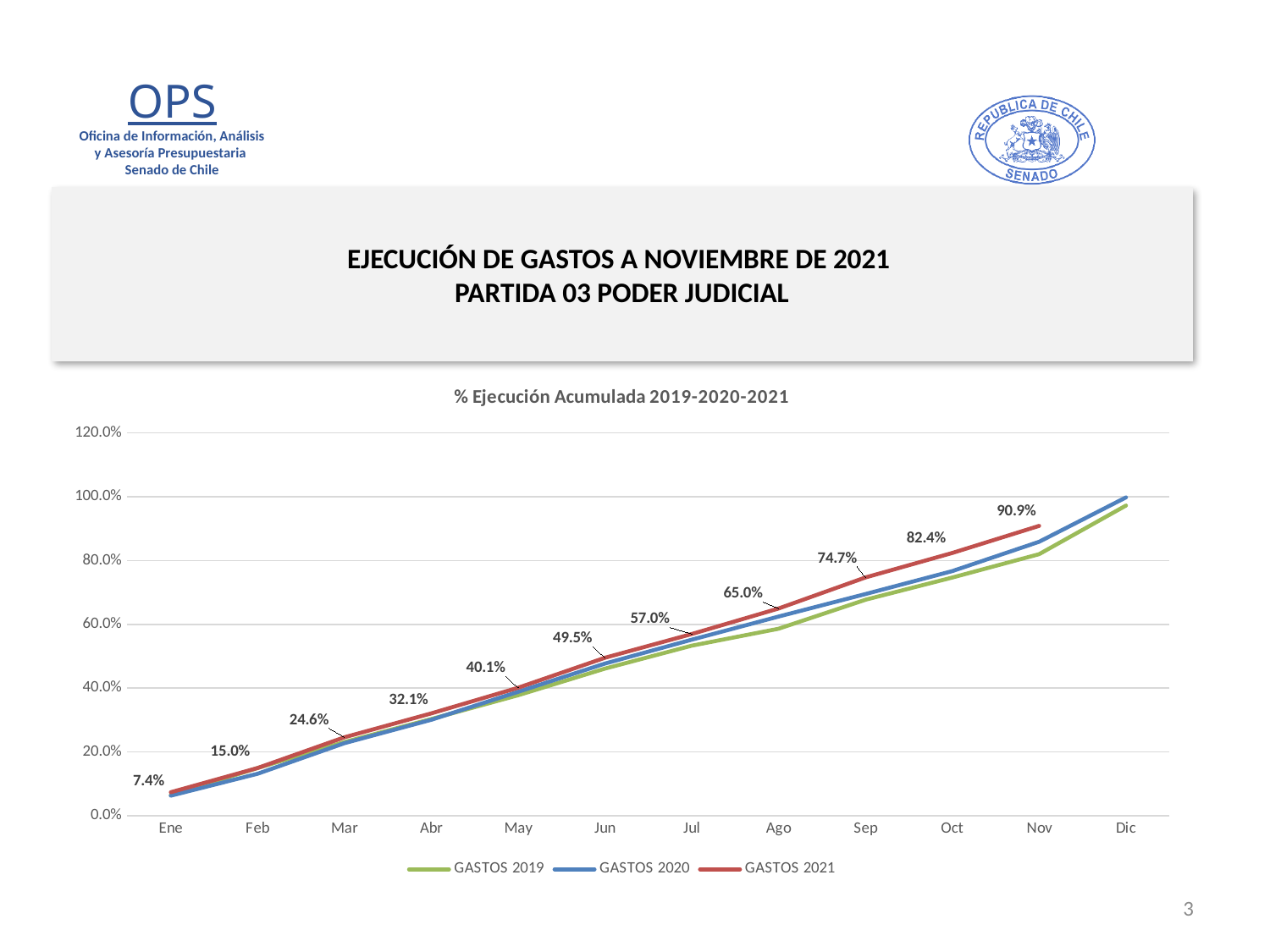
What is the value for GASTOS 2021 in Nov? 90.9% What is the difference between the GASTOS 2021 values for Sep and Jul? 17.7% What is the difference between the GASTOS 2021 values for Nov and Oct? 8.5% Is the value for GASTOS 2020 in Dic greater or less than 80.0%? greater Do the GASTOS 2021 values rise or fall from Ene to Nov? rise What is the value for GASTOS 2021 in Ago? 65.0% What is the value for GASTOS 2021 in Ene? 7.4% Which month has the lowest labelled value for GASTOS 2021? Ene How many series does the legend list? 3 What is the value for GASTOS 2021 in Jun? 49.5% What kind of chart is shown? line chart Which month has the highest labelled value for GASTOS 2021? Nov